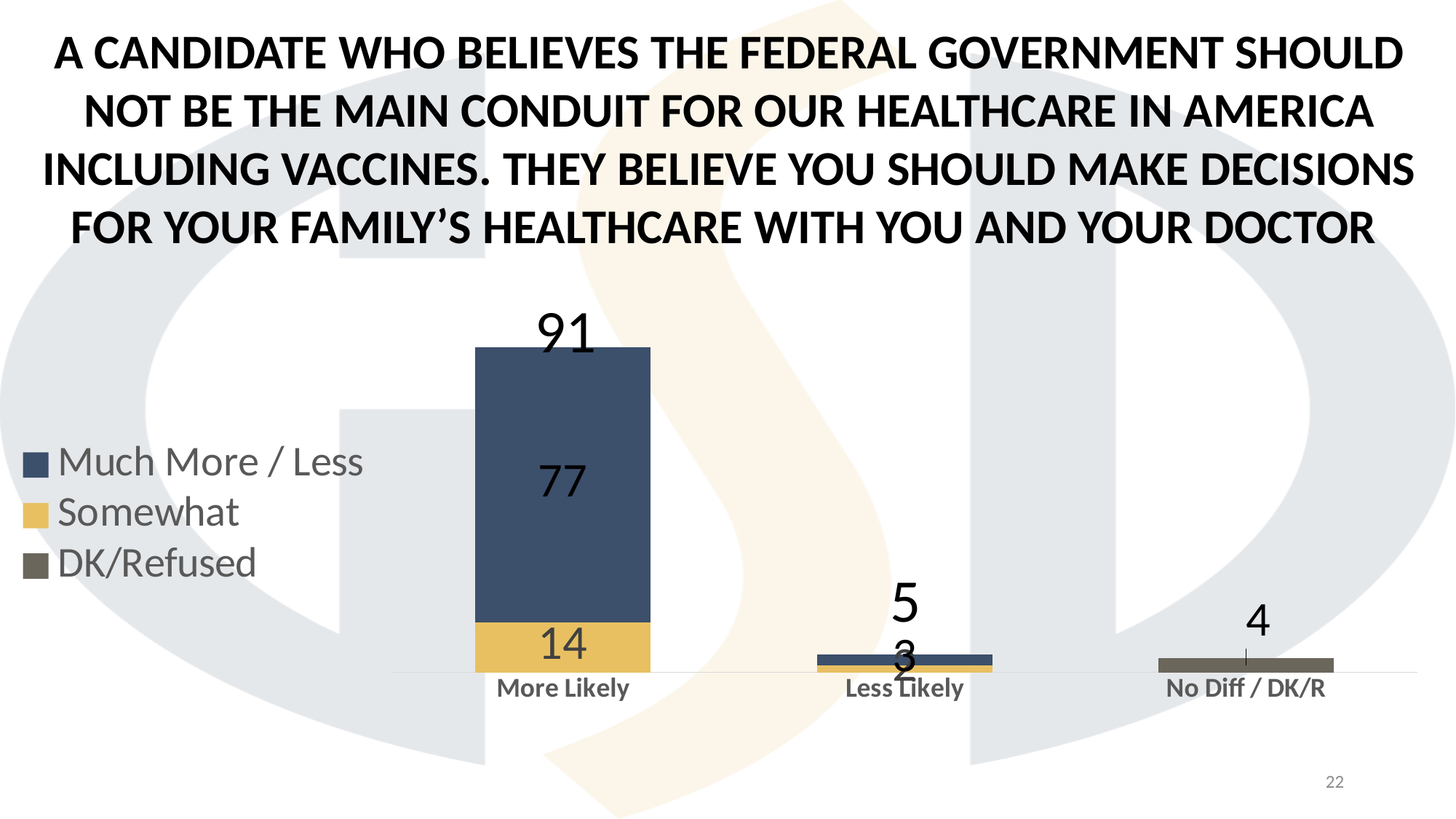
How many series does the legend list? 3 Which category has the lowest total? No Diff / DK/R How many categories are shown on the x axis? 3 What is the total shown above the Less Likely bar? 5 Which is larger, the Much More / Less value for More Likely or the Somewhat value for More Likely? Much More / Less What kind of chart is shown on the slide? Stacked bar chart What is the total shown above the More Likely bar? 91 What is the difference between the More Likely total and the Less Likely total? 86 Which category has the highest total? More Likely What is the Somewhat value for More Likely? 14 What is the value for No Diff / DK/R? 4 What is the Much More / Less value for More Likely? 77